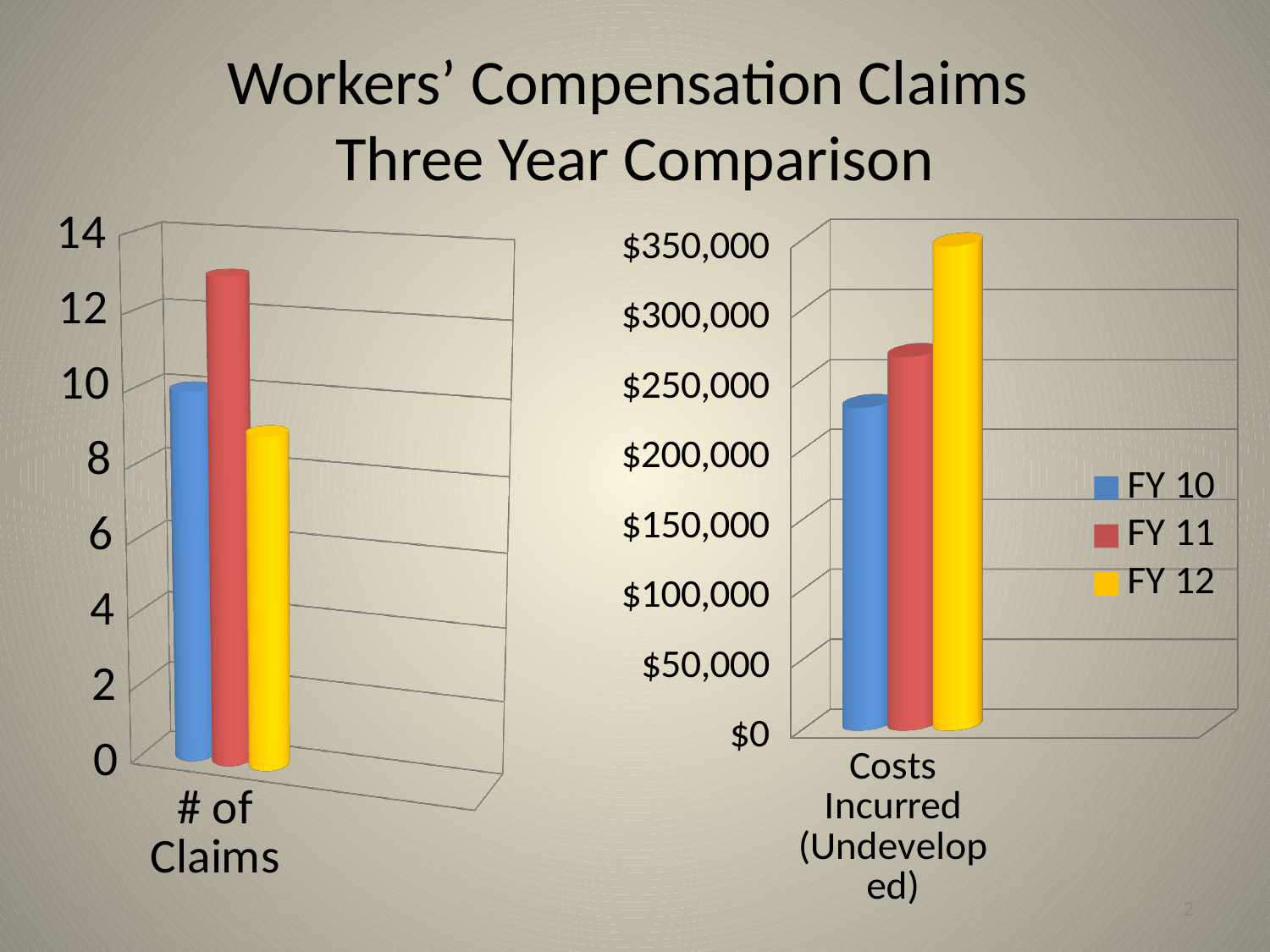
In the right chart (Costs Incurred (Undeveloped)), is the value for FY 12 greater or less than $300,000? greater In the right chart (Costs Incurred (Undeveloped)), which fiscal year has the lowest cost? FY 10 What colour represents FY 12 in the legend? yellow In the right chart (Costs Incurred (Undeveloped)), which is larger, the value for FY 11 or the value for FY 10? FY 11 In the left chart (# of Claims), is the value for FY 11 greater or less than 12? greater In the left chart (# of Claims), which fiscal year has the lowest number of claims? FY 12 In the left chart (# of Claims), which fiscal year has the highest number of claims? FY 11 In the right chart (Costs Incurred (Undeveloped)), which fiscal year has the highest cost? FY 12 What kind of chart is the left chart (# of Claims)? bar chart In the right chart (Costs Incurred (Undeveloped)), is the value for FY 10 greater or less than $250,000? less How many series does the legend on the slide list? 3